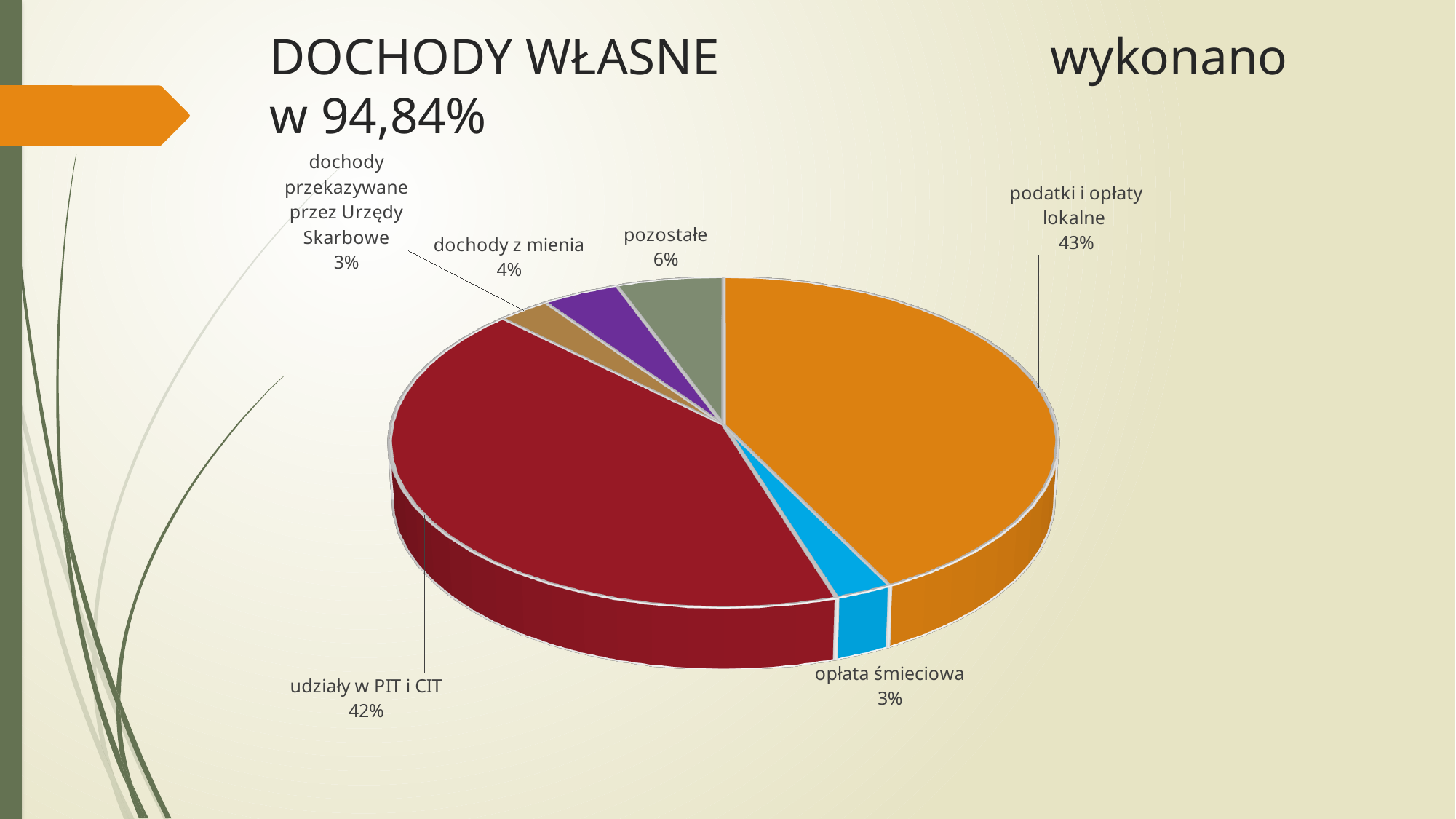
What kind of chart is shown on the slide? pie chart Which category has the largest share of the pie? podatki i opłaty lokalne How many slices does the pie chart have? 6 What is the difference in percentage points between "podatki i opłaty lokalne" and "udziały w PIT i CIT"? 1 What is the value shown for "opłata śmieciowa"? 3% What is the value shown for "pozostałe"? 6% What share of the pie does "podatki i opłaty lokalne" have? 43% What share of the pie does "udziały w PIT i CIT" have? 42% What is the value shown for "dochody z mienia"? 4% What is the value shown for "dochody przekazywane przez Urzędy Skarbowe"? 3% What colour is the "udziały w PIT i CIT" slice? dark red Which is larger: "podatki i opłaty lokalne" or "udziały w PIT i CIT"? podatki i opłaty lokalne